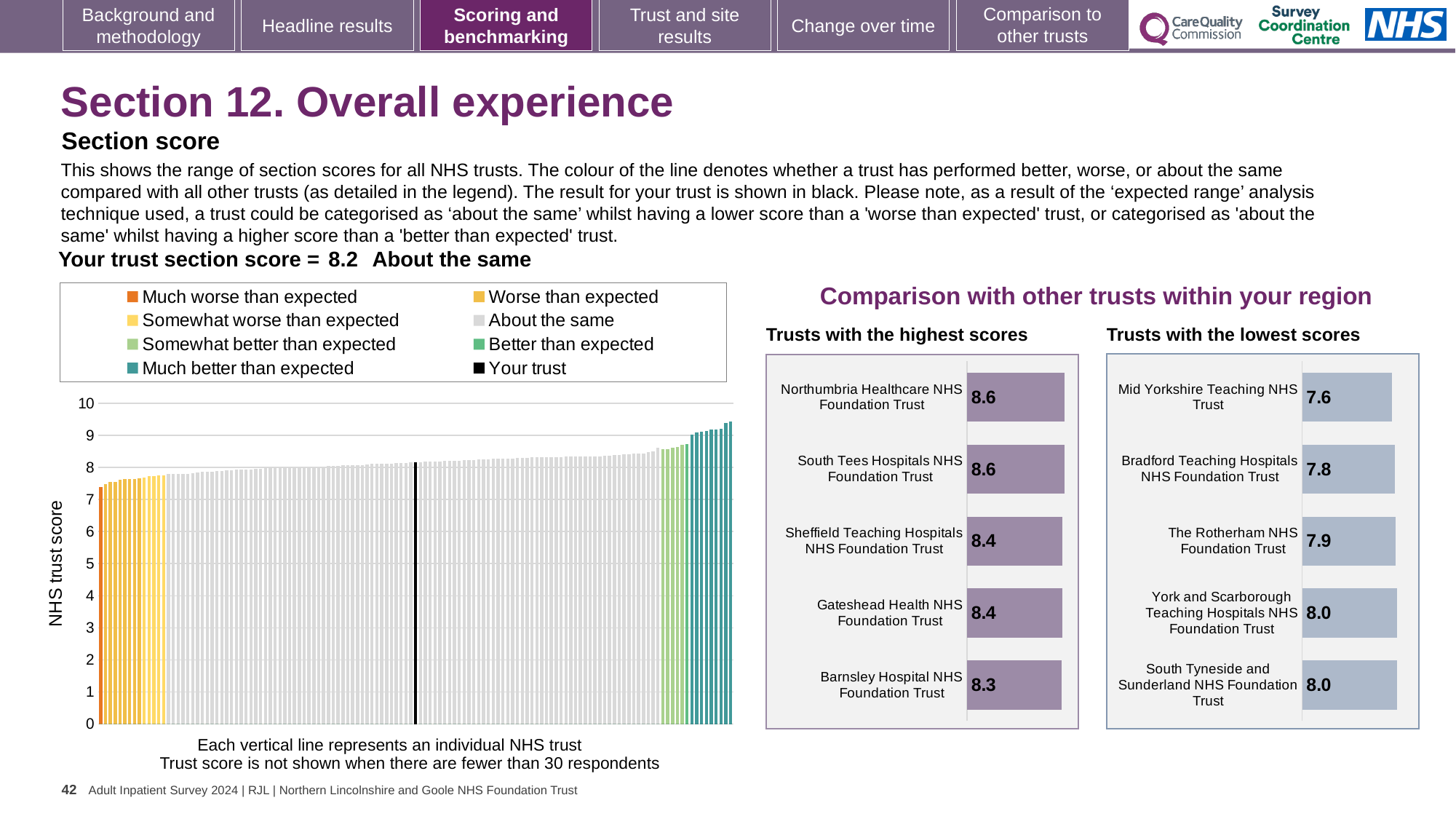
In the main chart on the left, do the trust scores rise or fall from left to right along the x axis? Rise In the 'Trusts with the highest scores' chart, what is the difference between the scores of Northumbria Healthcare NHS Foundation Trust and Barnsley Hospital NHS Foundation Trust? 0.3 Which is larger: the score for Gateshead Health NHS Foundation Trust in the highest scores chart or the score for The Rotherham NHS Foundation Trust in the lowest scores chart? Gateshead Health NHS Foundation Trust How many entries does the legend of the main chart on the left list? 8 In the 'Trusts with the lowest scores' chart, which trust has the lowest score? Mid Yorkshire Teaching NHS Trust In the 'Trusts with the highest scores' chart, what is the score for Sheffield Teaching Hospitals NHS Foundation Trust? 8.4 What is the label on the y axis of the main chart on the left? NHS trust score In the 'Trusts with the lowest scores' chart, what is the score for Bradford Teaching Hospitals NHS Foundation Trust? 7.8 In the 'Trusts with the lowest scores' chart, what is the difference between the scores of South Tyneside and Sunderland NHS Foundation Trust and Mid Yorkshire Teaching NHS Trust? 0.4 What kind of chart is the 'Trusts with the lowest scores' chart? Bar chart In the 'Trusts with the highest scores' chart, which trust has the lowest score? Barnsley Hospital NHS Foundation Trust How many trusts are shown in the 'Trusts with the highest scores' chart? 5